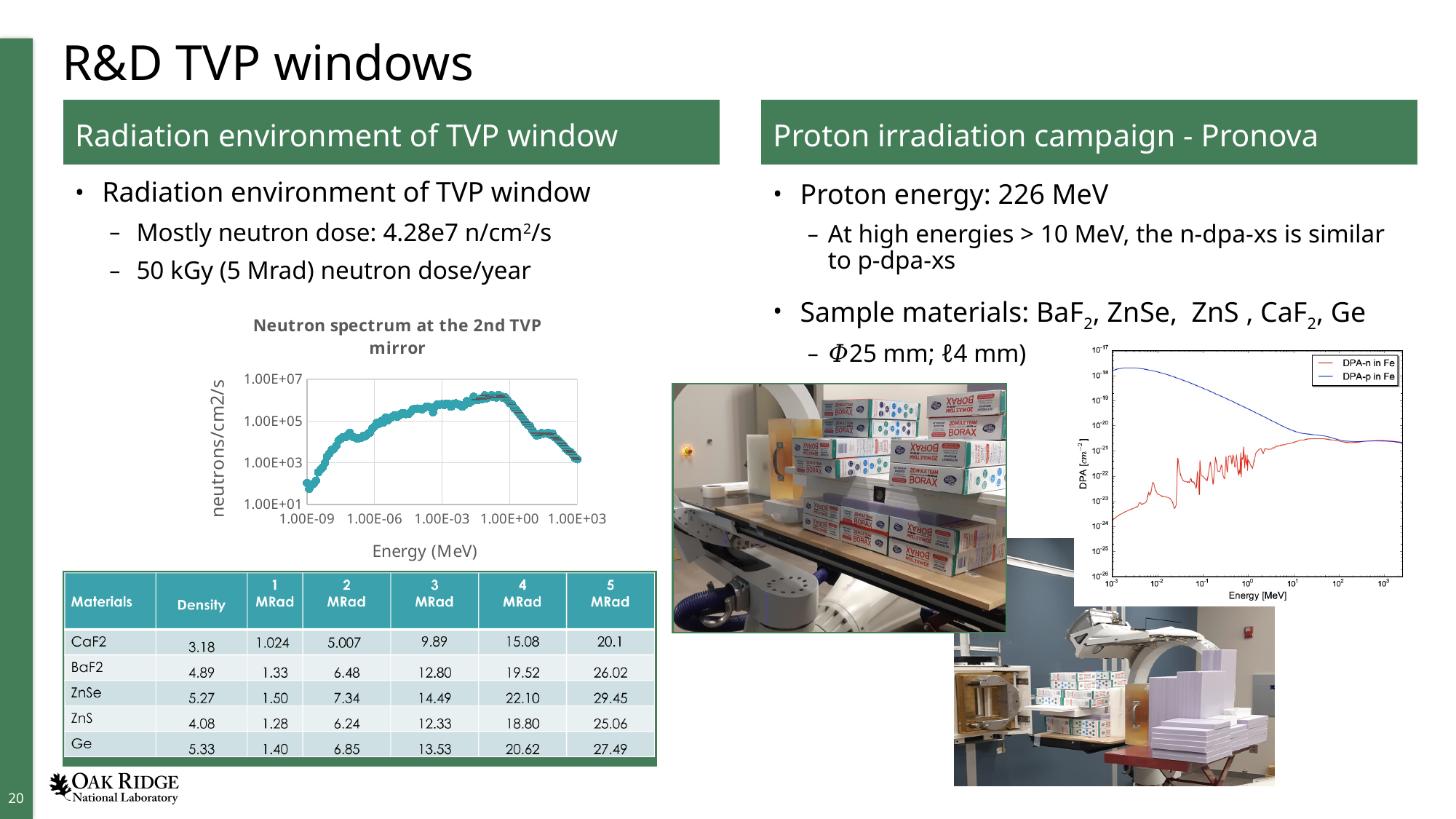
In the DPA chart on the right of the slide, does the DPA-p in Fe curve rise or fall as energy increases from 10^-3 MeV to 10^1 MeV? fall What kind of chart is the 'Neutron spectrum at the 2nd TVP mirror' chart? scatter chart In the DPA chart on the right of the slide, is the DPA-n in Fe value at 10^-3 MeV greater or less than 10^-22? less In the 'Neutron spectrum at the 2nd TVP mirror' chart, does the neutron flux rise or fall as energy increases from 1.00E+00 MeV to 1.00E+03 MeV? fall In the DPA chart on the right of the slide, which series has the higher value at 10^-3 MeV, DPA-n in Fe or DPA-p in Fe? DPA-p in Fe What kind of chart is the DPA chart on the right of the slide? line chart In the 'Neutron spectrum at the 2nd TVP mirror' chart, is the neutron flux at the lowest plotted energy (near 1.00E-09 MeV) greater or less than 1.00E+03? less What is the x-axis label of the 'Neutron spectrum at the 2nd TVP mirror' chart? Energy (MeV) What is the y-axis label of the 'Neutron spectrum at the 2nd TVP mirror' chart? neutrons/cm2/s In the 'Neutron spectrum at the 2nd TVP mirror' chart, is the peak neutron flux greater or less than 1.00E+05? greater How many series does the legend of the DPA chart on the right of the slide list? 2 In the 'Neutron spectrum at the 2nd TVP mirror' chart, does the neutron flux rise or fall as energy increases from 1.00E-09 MeV to 1.00E-03 MeV? rise